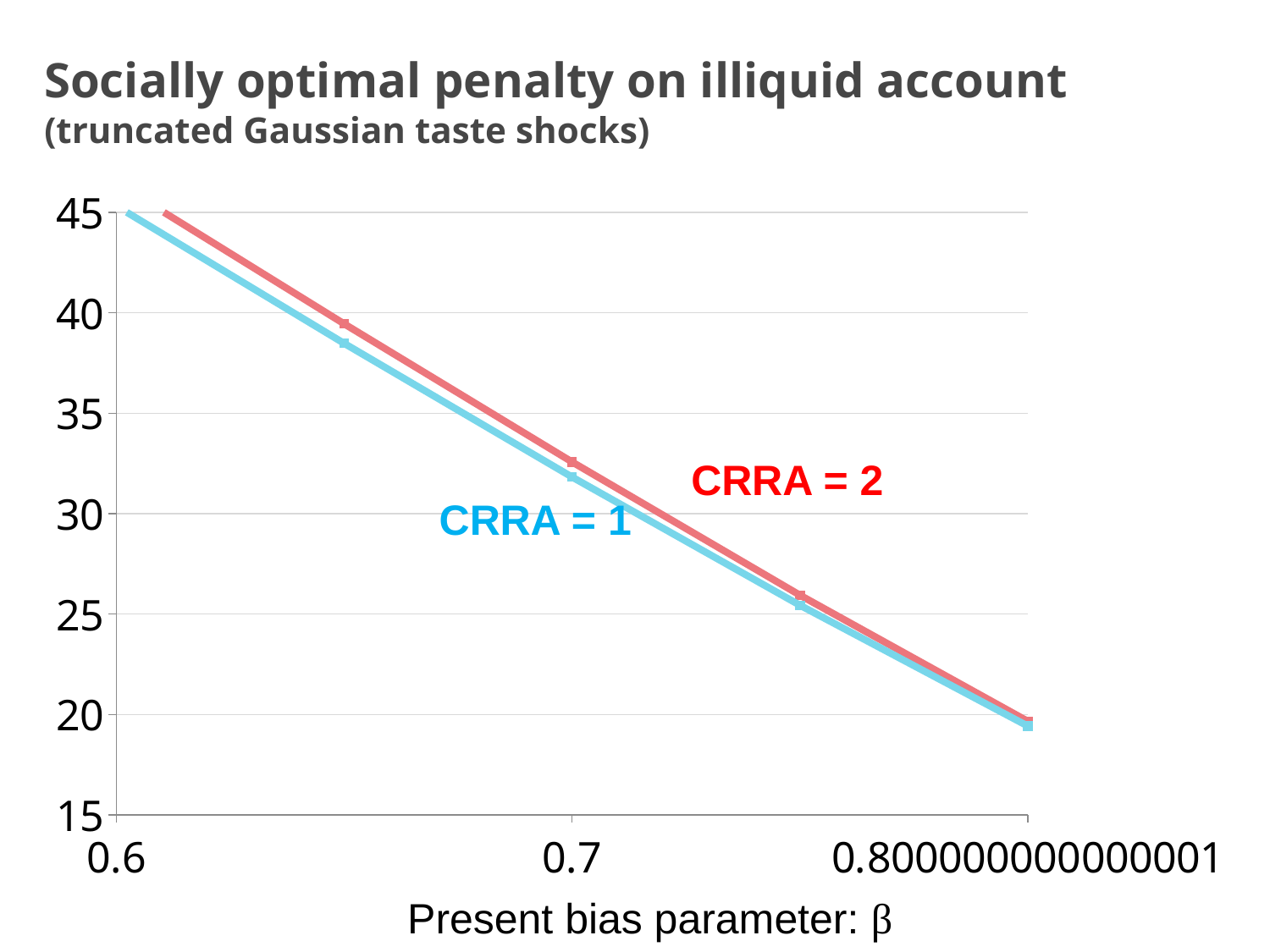
Is the value for CRRA = 2 at β = 0.8 greater or less than 25? less What is the title of the chart? Socially optimal penalty on illiquid account (truncated Gaussian taste shocks) Is the value for CRRA = 2 at β = 0.7 greater or less than 30? greater Do the values of the CRRA = 2 line rise or fall as β increases along the x axis? fall Is the value for CRRA = 1 at β = 0.7 greater or less than 30? greater How many series are plotted on the chart? 2 What kind of chart is shown on the slide? line chart Do the values of the CRRA = 1 line rise or fall as the present bias parameter β increases? fall What is the label of the x axis? Present bias parameter: β At β = 0.7, which series has the higher value, CRRA = 1 or CRRA = 2? CRRA = 2